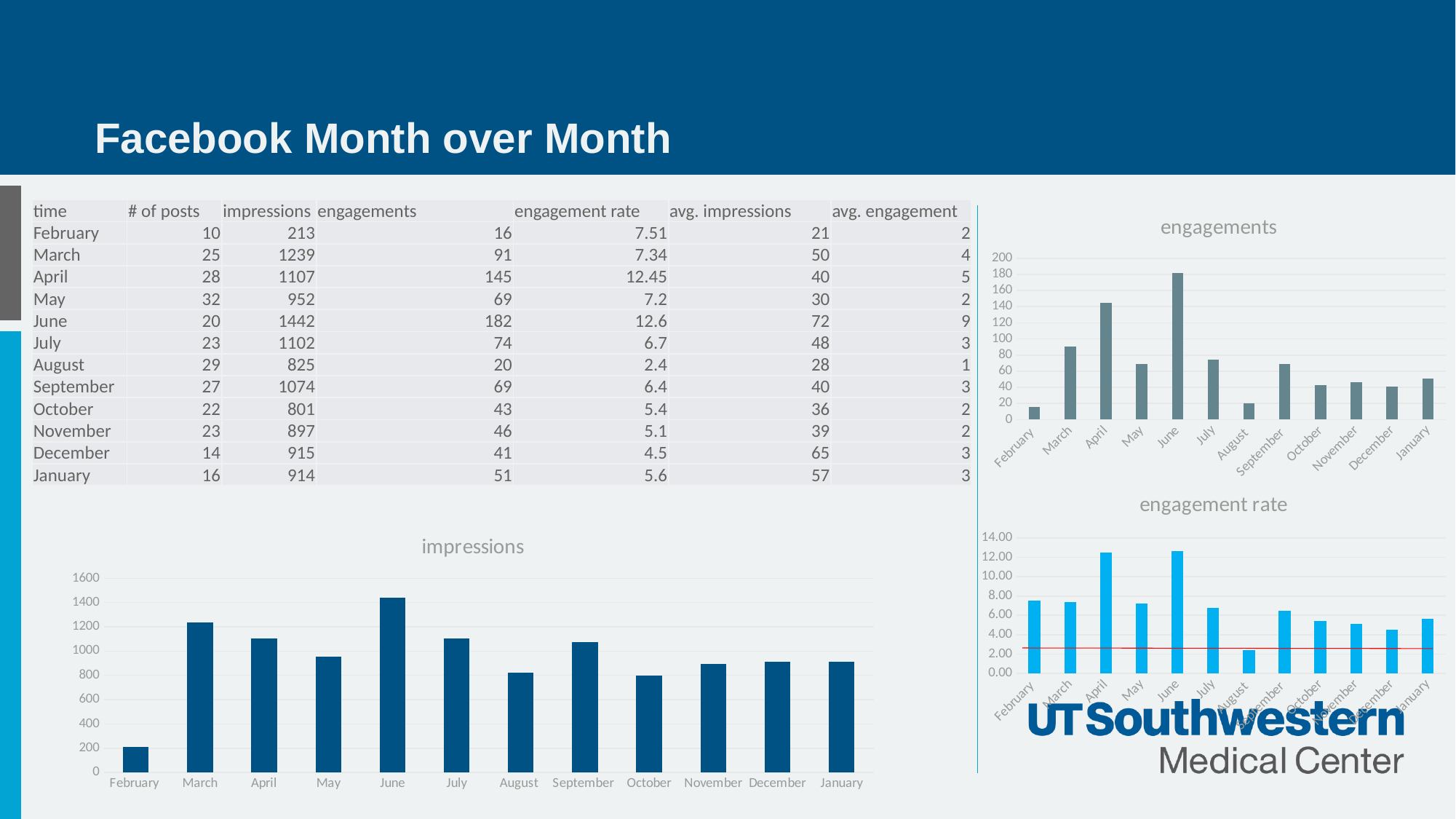
In the impressions chart, which is larger, March or April? March In the engagements chart, is the value for April greater or less than 120? greater What kind of chart is the impressions chart at the bottom left of the slide? bar chart In the impressions chart, which month has the highest value? June How many months are plotted in the impressions chart? 12 In the impressions chart, is the value for August greater or less than 1000? less According to the table on the slide, what is the impressions value for June? 1442 In the impressions chart, which month has the lowest value? February In the engagement rate chart, is the value for February greater or less than 6.00? greater Using the values in the table, what is the difference in engagements between June and April? 37 In the engagements chart, which month has the highest value? June In the engagement rate chart, which month has the lowest value? August